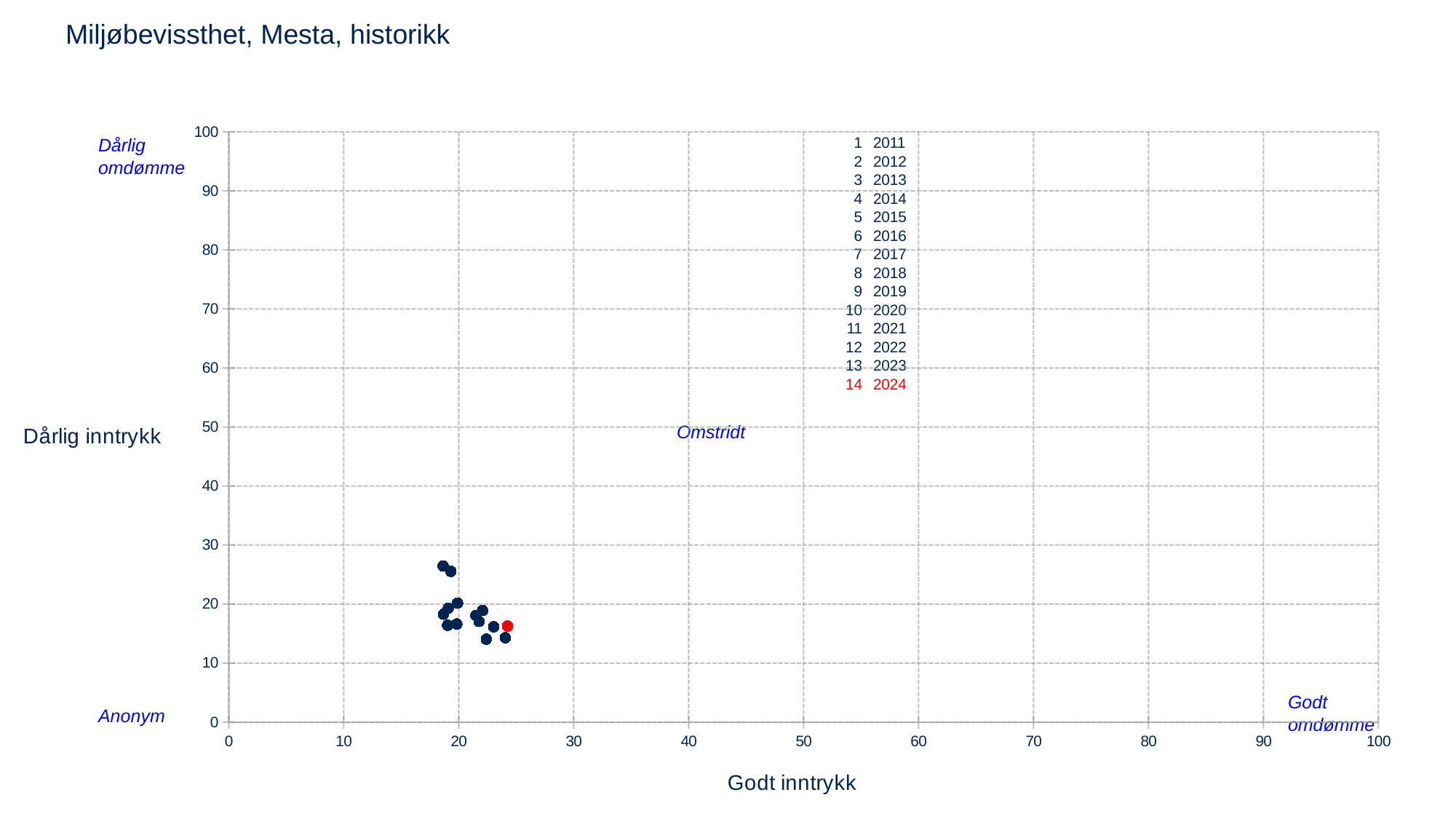
What kind of chart is shown on the slide? scatter chart What is the label of the x-axis? Godt inntrykk Which year does the legend list as number 1? 2011 Which year is shown in red in the legend? 2024 Which year does the legend list as number 10? 2020 What is the title of the slide? Miljøbevissthet, Mesta, historikk Is the y-axis value of the red point (2024) greater or less than 20? less Is the x-axis value of the red point (2024) greater or less than 20? greater How many years are listed in the chart's legend? 14 Are all the plotted points below or above 30 on the y-axis? below